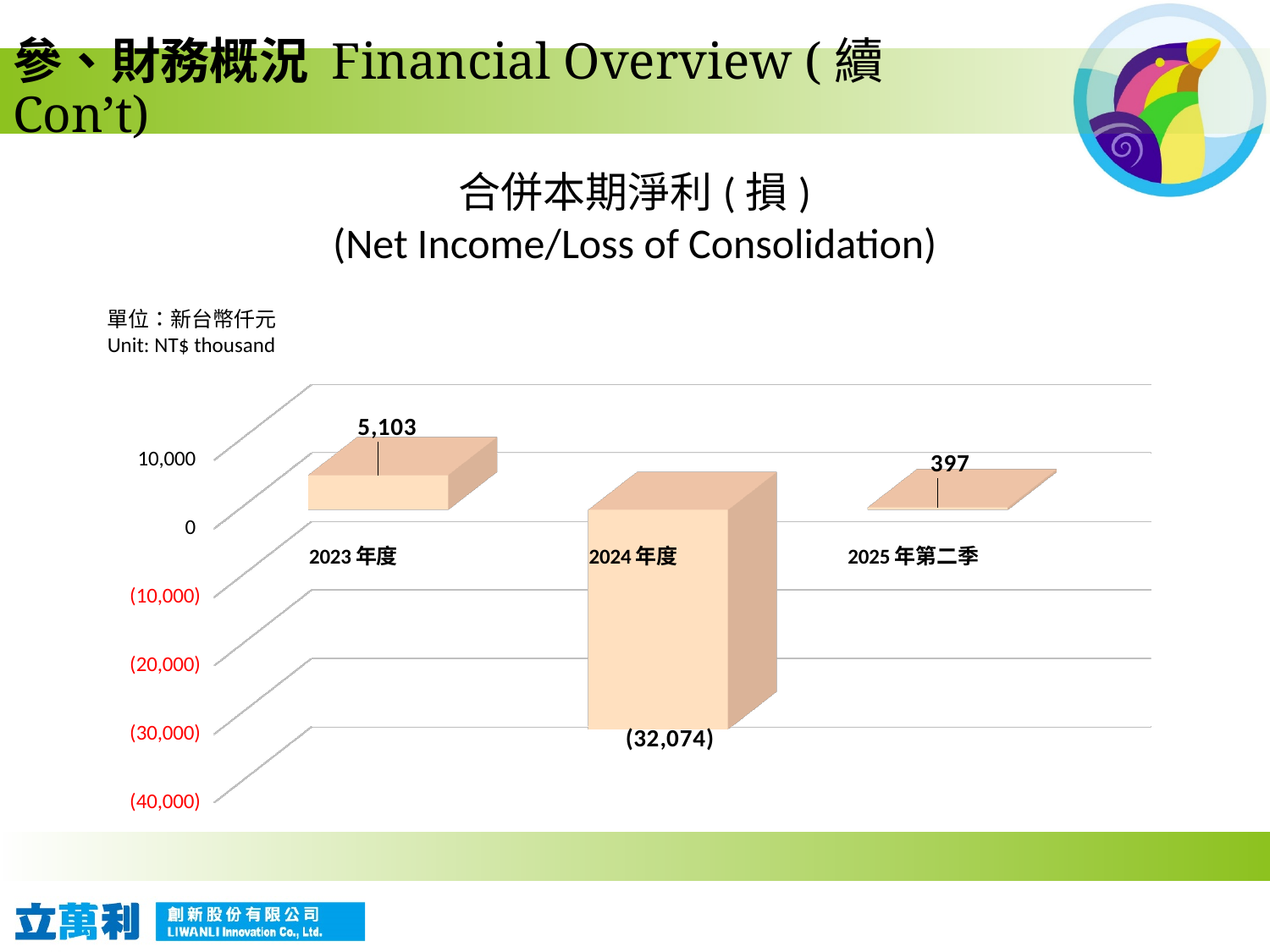
What is the value for 2024 年度? (32,074) What kind of chart is shown on the slide? bar chart Which category has the lowest value? 2024 年度 Which category has the highest value? 2023 年度 How many categories are shown on the chart? 3 What is the value for 2025 年第二季? 397 What is the English title of the chart? Net Income/Loss of Consolidation Which is larger, the value for 2023 年度 or the value for 2025 年第二季? 2023 年度 Is the value for 2024 年度 greater or less than (30,000)? less What unit is the chart's data expressed in? NT$ thousand What is the difference between the values for 2023 年度 and 2025 年第二季? 4,706 What is the value for 2023 年度? 5,103